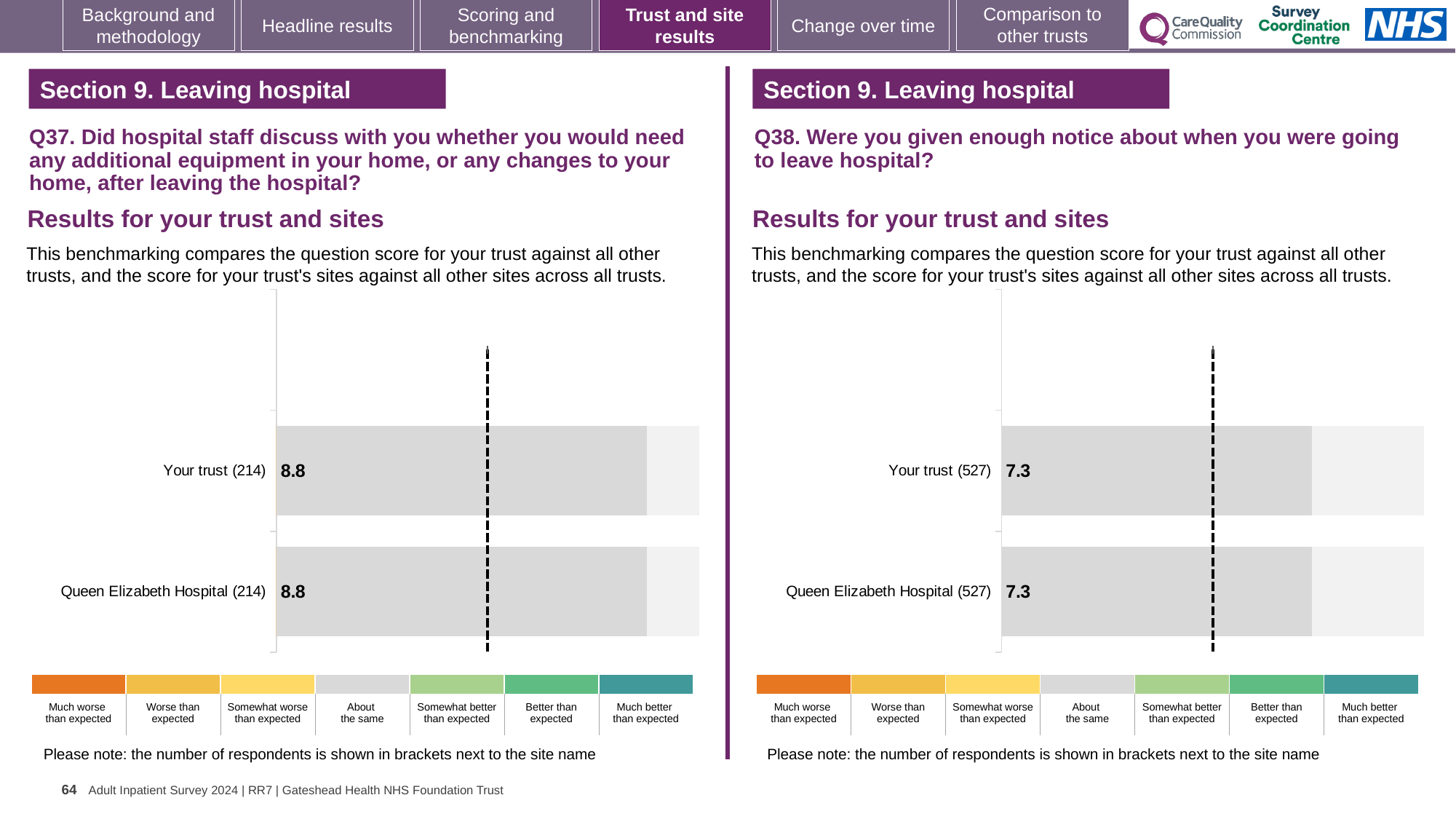
In the Q38 chart on the right, is the score for Queen Elizabeth Hospital greater or less than 8? less How many bars are plotted in the Q38 chart on the right? 2 How many categories does the colour key below the Q38 chart on the right list? 7 In the Q37 chart on the left, what is the score for Your trust? 8.8 What kind of chart is the Q37 chart on the left? Bar chart In the Q37 chart on the left, how many respondents are shown in brackets next to Your trust? 214 Which is larger: the Your trust score in the Q37 chart on the left or the Your trust score in the Q38 chart on the right? Q37 chart (8.8) In the Q38 chart on the right, what is the score for Your trust? 7.3 In the Q37 chart on the left, what is the difference between the score for Your trust and the score for Queen Elizabeth Hospital? 0.0 In the Q38 chart on the right, how many respondents are shown in brackets next to Queen Elizabeth Hospital? 527 In the Q37 chart on the left, what is the score for Queen Elizabeth Hospital? 8.8 In the Q38 chart on the right, what is the score for Queen Elizabeth Hospital? 7.3